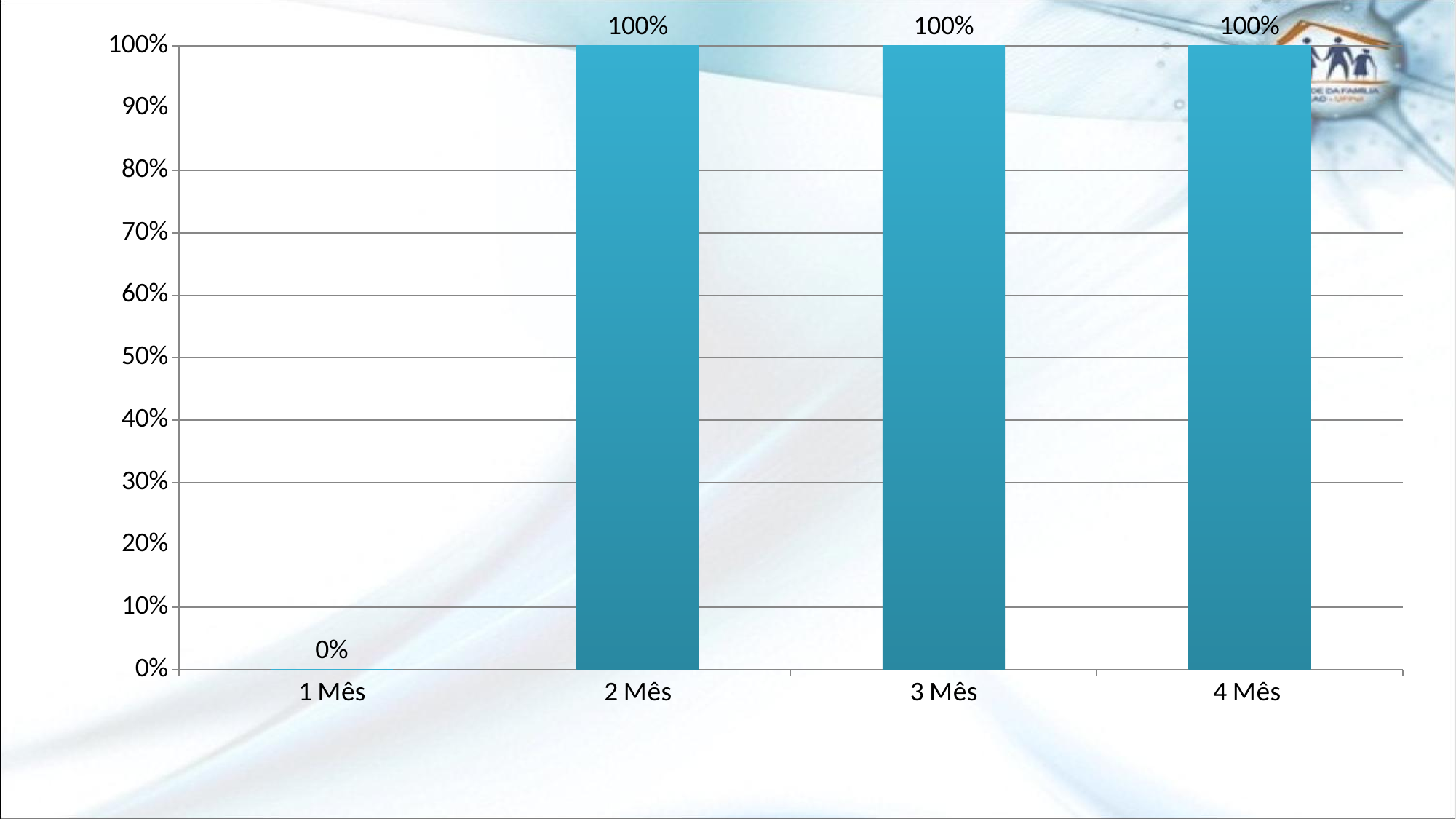
What is the value for 4 Mês? 100% Which is larger, the value for 1 Mês or the value for 3 Mês? 3 Mês How many categories are shown on the x axis? 4 What is the value for 3 Mês? 100% Which category has the lowest value? 1 Mês What is the value for 2 Mês? 100% What is the highest value shown on the y axis? 100% What kind of chart is shown on the slide? bar chart Is the value for 4 Mês greater or less than 50%? greater Do the values rise or fall from 1 Mês to 2 Mês? rise What is the value for 1 Mês? 0% What is the difference between the values for 2 Mês and 1 Mês? 100%